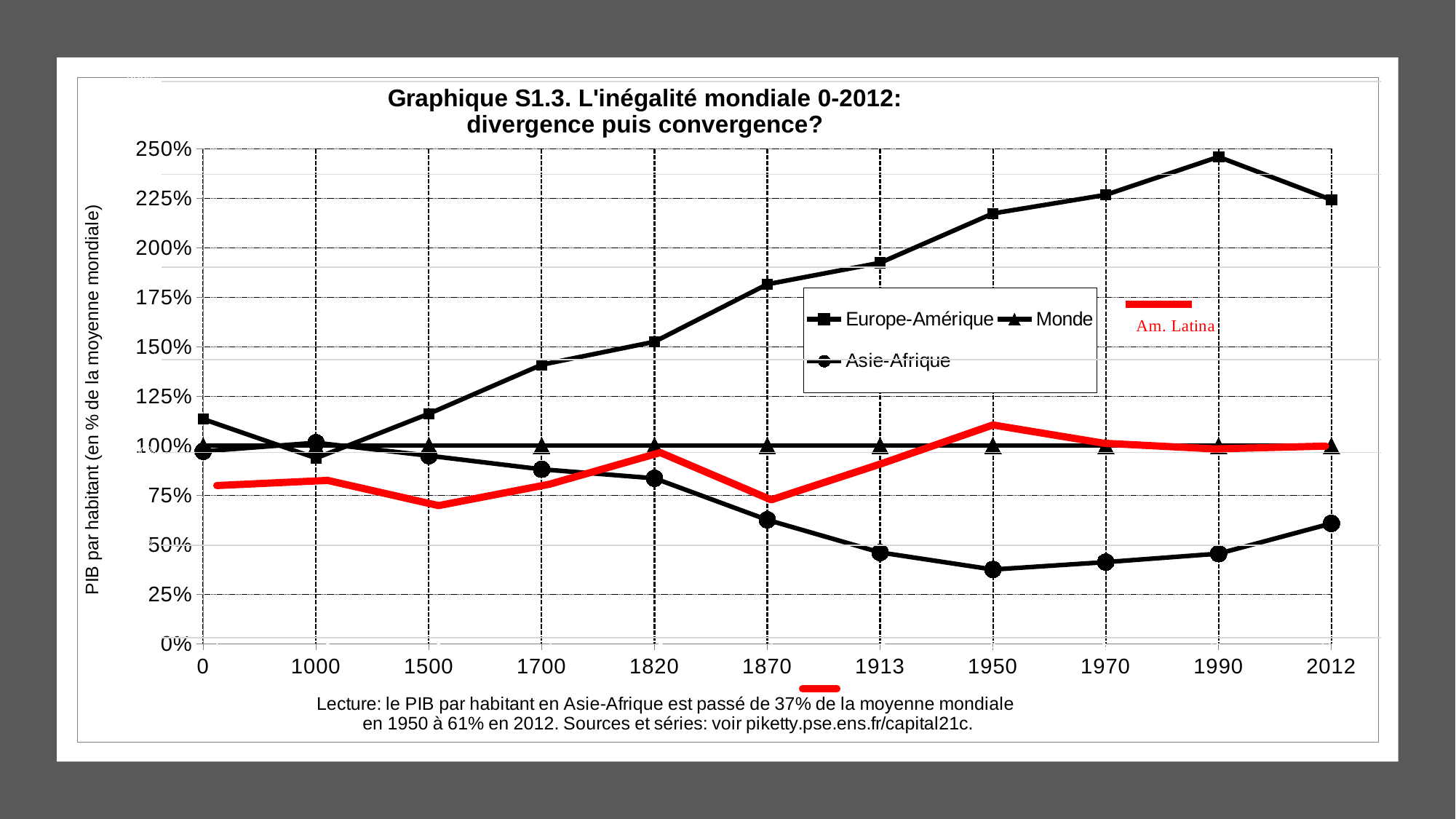
By how many percentage points did the Asie-Afrique value rise between 1950 and 2012? 24 percentage points Is the value for Am. Latina in 1950 greater or less than 100%? greater What is the value of the Monde series in 1820? 100% Is the value for Europe-Amérique in 1990 greater or less than 225%? greater Which series has the higher value in 2012, Europe-Amérique or Asie-Afrique? Europe-Amérique What kind of chart is shown on the slide? line chart In which year does the Europe-Amérique series reach its highest value? 1990 What was the Asie-Afrique value in 2012, according to the note under the chart? 61% How many time points are shown along the x axis? 11 How many series are plotted on the chart? 4 What was the Asie-Afrique value in 1950, according to the note under the chart? 37% In which year does the Asie-Afrique series reach its lowest value? 1950